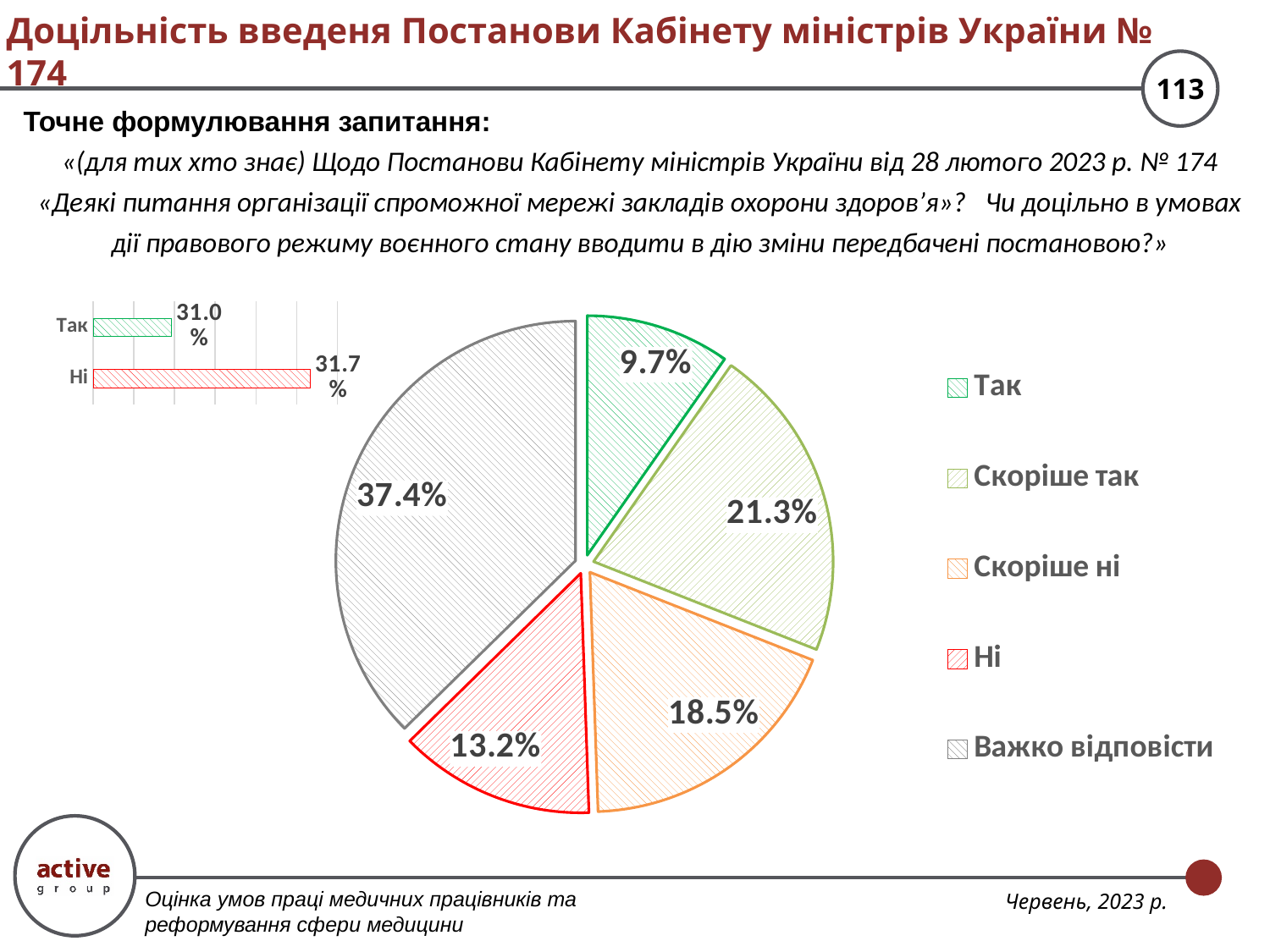
In the pie chart, what is the value shown for 'Скоріше ні'? 18.5% In the pie chart, which category has the smallest slice? Так How many entries does the legend of the pie chart list? 5 In the pie chart, what share is labelled for the slice 'Важко відповісти'? 37.4% In the small bar chart at the top left, what is the value for 'Так'? 31.0% In the pie chart, which is larger: 'Ні' or 'Так'? Ні In the pie chart, what is the value shown for 'Скоріше так'? 21.3% In the pie chart, which category has the largest slice? Важко відповісти In the pie chart, what is the difference between the 'Скоріше так' and 'Скоріше ні' slices? 2.8% How many slices does the pie chart have? 5 What kind of chart is the small chart at the top left of the slide? Bar chart In the small bar chart at the top left, what is the value for 'Ні'? 31.7%